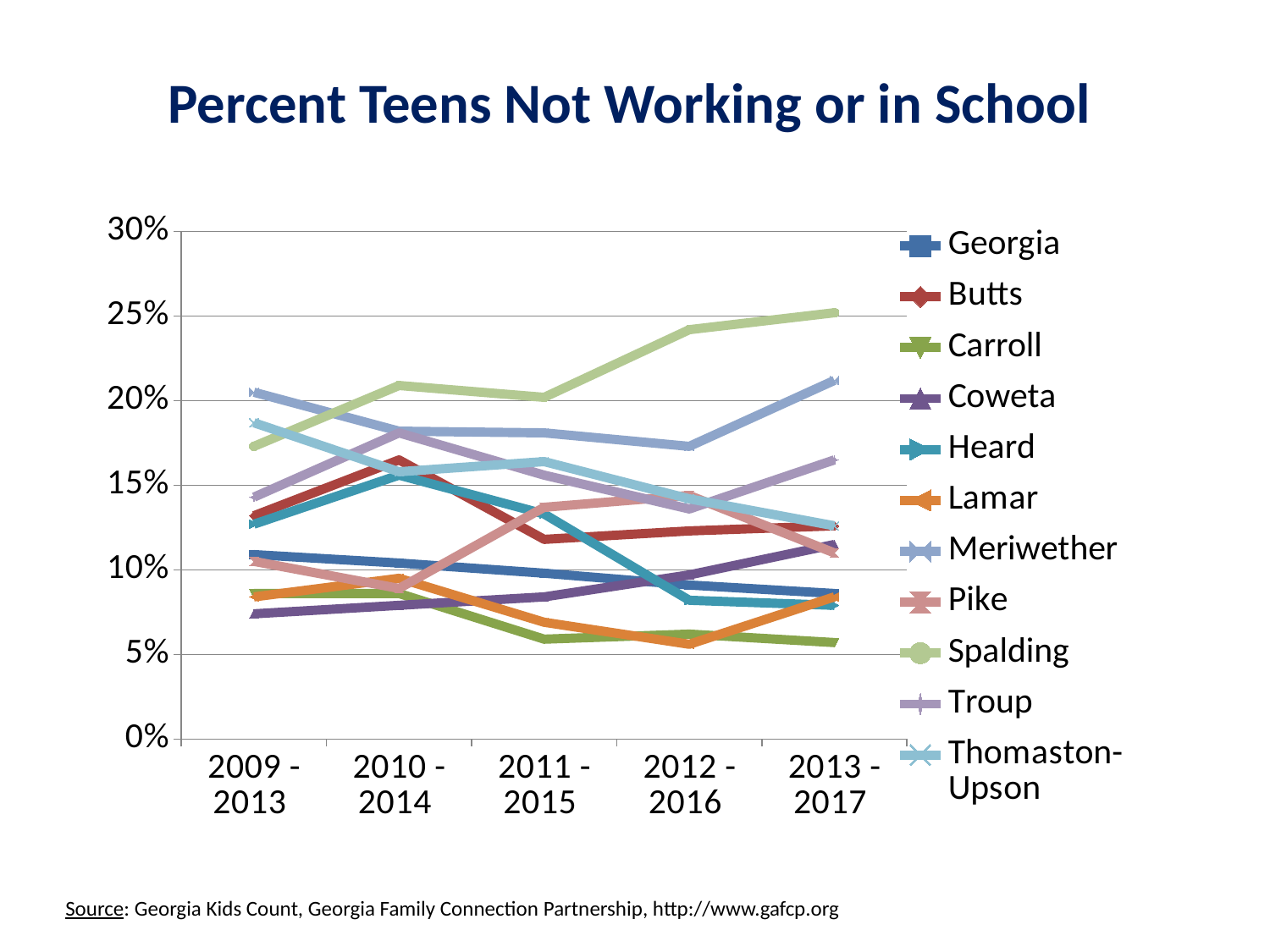
Which series has the lowest value in the 2013 - 2017 period? Carroll Which series has the highest value in the 2009 - 2013 period? Meriwether Is the value for Spalding in 2013 - 2017 greater or less than 20%? greater Is the value for Meriwether in 2012 - 2016 greater or less than 20%? less How many time periods are shown on the x axis? 5 What is the title of the chart? Percent Teens Not Working or in School Which is larger in 2013 - 2017, the value for Spalding or the value for Georgia? Spalding Which series has the highest value in the 2013 - 2017 period? Spalding Is the value for Georgia in 2009 - 2013 greater or less than 10%? greater What kind of chart is shown on the slide? line chart Does the Georgia line rise or fall from 2009 - 2013 to 2013 - 2017? fall How many series does the legend list? 11